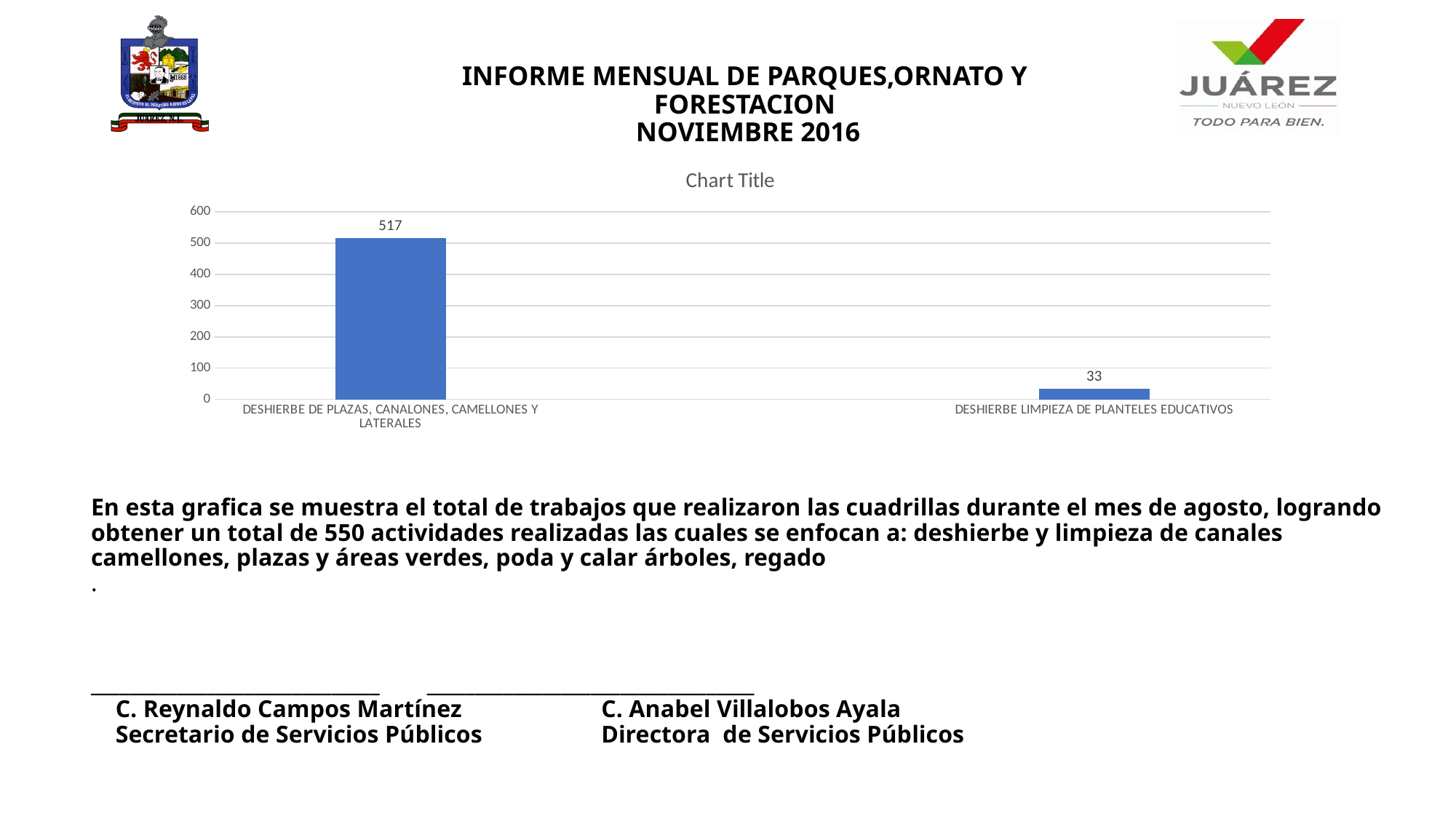
Which is larger: the value for DESHIERBE DE PLAZAS, CANALONES, CAMELLONES Y LATERALES or the value for DESHIERBE LIMPIEZA DE PLANTELES EDUCATIVOS? DESHIERBE DE PLAZAS, CANALONES, CAMELLONES Y LATERALES What is the title shown above the chart? Chart Title Is the value for DESHIERBE LIMPIEZA DE PLANTELES EDUCATIVOS greater or less than 100? less What is the value for DESHIERBE LIMPIEZA DE PLANTELES EDUCATIVOS? 33 What is the value for DESHIERBE DE PLAZAS, CANALONES, CAMELLONES Y LATERALES? 517 How many categories are shown in the chart? 2 What is the difference between the values for DESHIERBE DE PLAZAS, CANALONES, CAMELLONES Y LATERALES and DESHIERBE LIMPIEZA DE PLANTELES EDUCATIVOS? 484 Which category has the highest value? DESHIERBE DE PLAZAS, CANALONES, CAMELLONES Y LATERALES What is the highest value shown on the vertical axis? 600 What kind of chart is shown on the slide? bar chart Is the value for DESHIERBE DE PLAZAS, CANALONES, CAMELLONES Y LATERALES greater or less than 500? greater Which category has the lowest value? DESHIERBE LIMPIEZA DE PLANTELES EDUCATIVOS